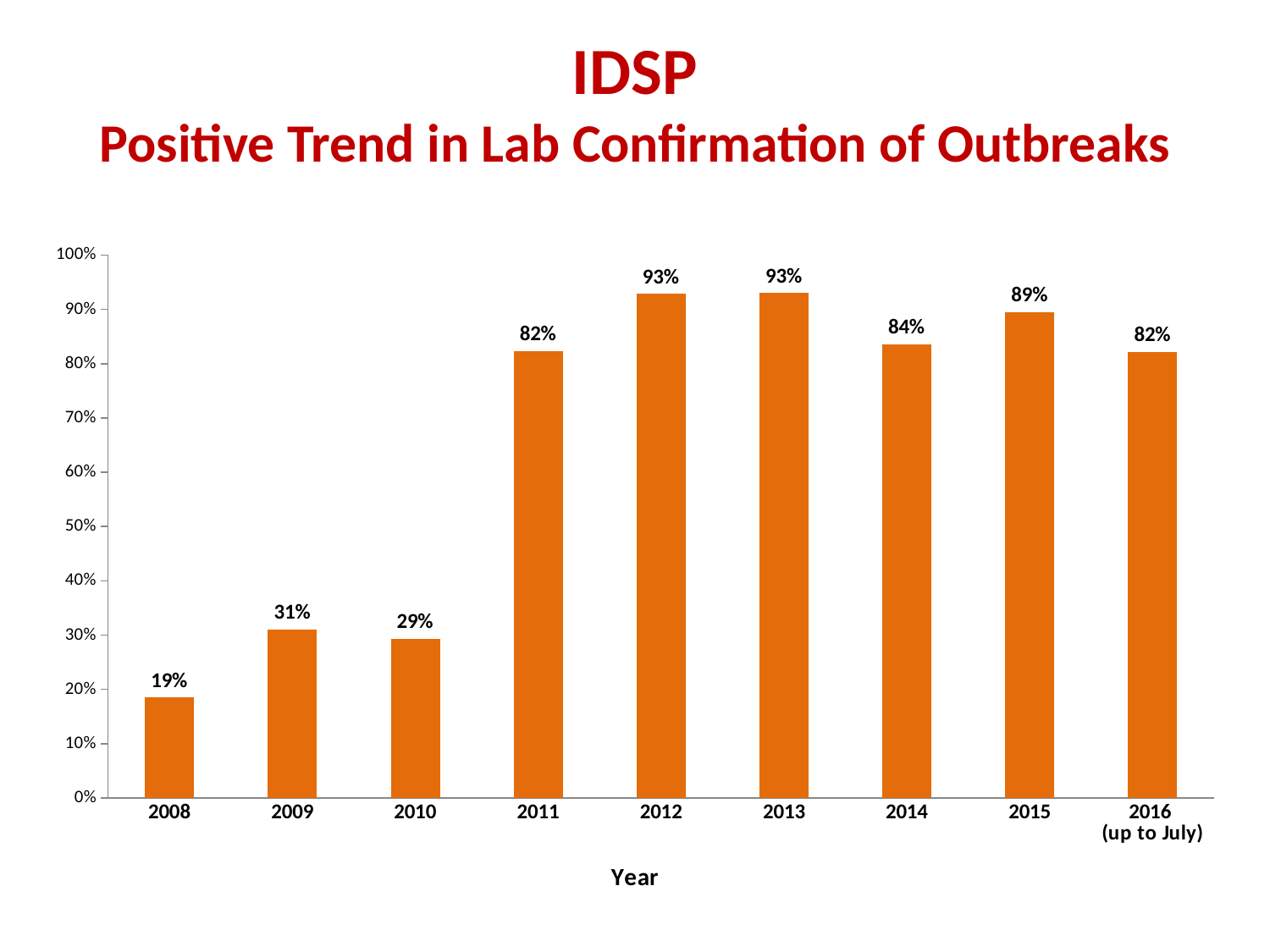
What is the value shown for 2016 (up to July)? 82% What is the value shown for 2011? 82% What is the lab confirmation percentage for 2008? 19% Which year has the larger value, 2009 or 2010? 2009 What is the value shown for 2015? 89% What is the label of the x axis? Year What kind of chart is shown on the slide? Bar chart What is the difference between the values for 2013 and 2014? 9% How many years are shown on the x axis? 9 Which year has the lowest lab confirmation percentage? 2008 Which years share the highest value on the chart? 2012 and 2013 What is the difference between the values for 2011 and 2010? 53%